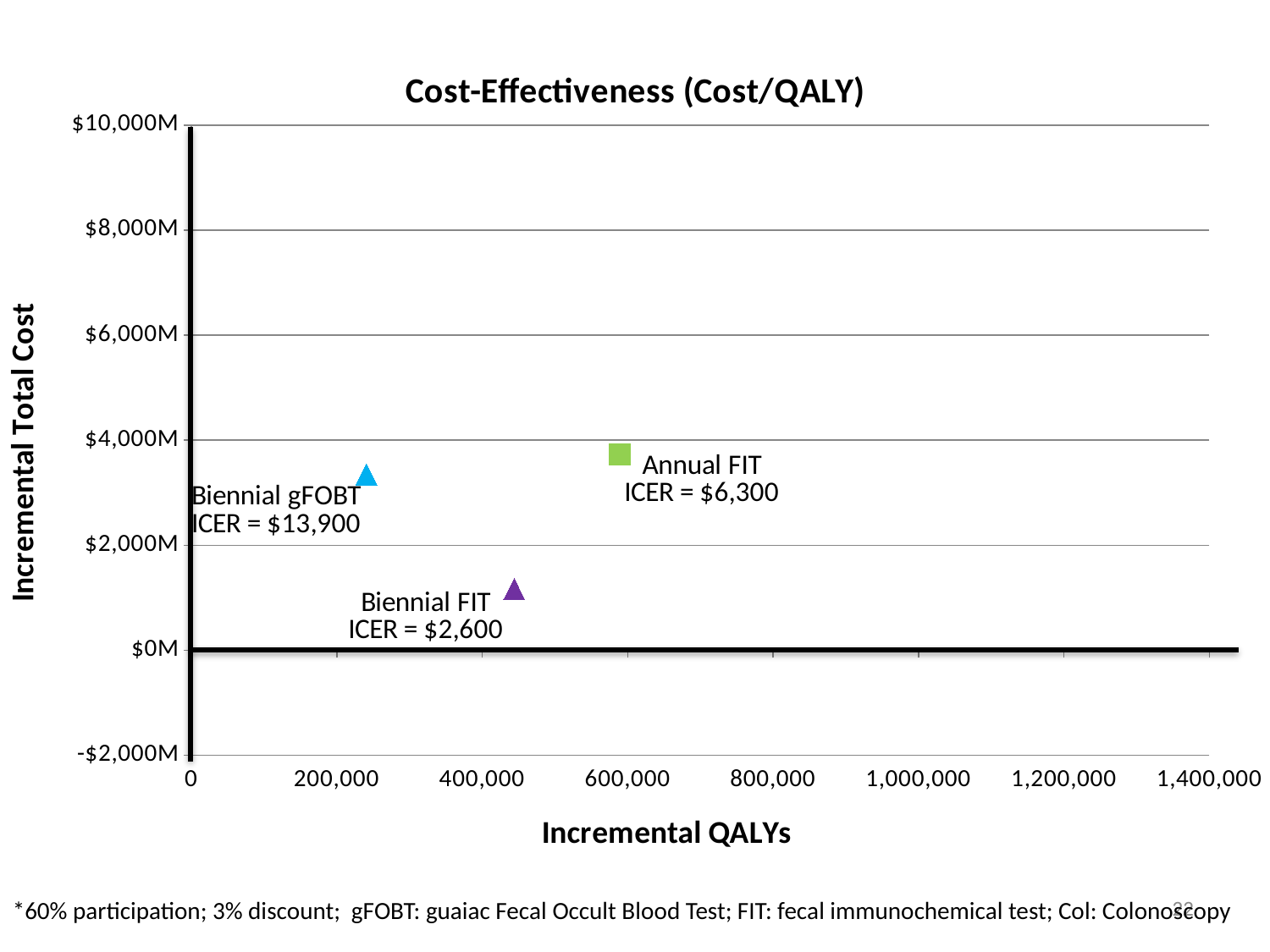
What is the ICER shown for Biennial gFOBT? $13,900 What is the ICER shown for Annual FIT? $6,300 Which strategy has more incremental QALYs, Annual FIT or Biennial gFOBT? Annual FIT How many screening strategies are plotted as points on the chart? 3 Are the incremental QALYs for Biennial gFOBT greater or less than 400,000? less Which strategy has the highest ICER labelled on the chart? Biennial gFOBT What kind of chart is shown on the slide? scatter chart Which strategy has the lowest ICER labelled on the chart? Biennial FIT Is the incremental total cost for Biennial FIT greater or less than $2,000M? less Is the incremental total cost for Annual FIT greater or less than $2,000M? greater What is the title of the chart? Cost-Effectiveness (Cost/QALY) What is the ICER shown for Biennial FIT? $2,600